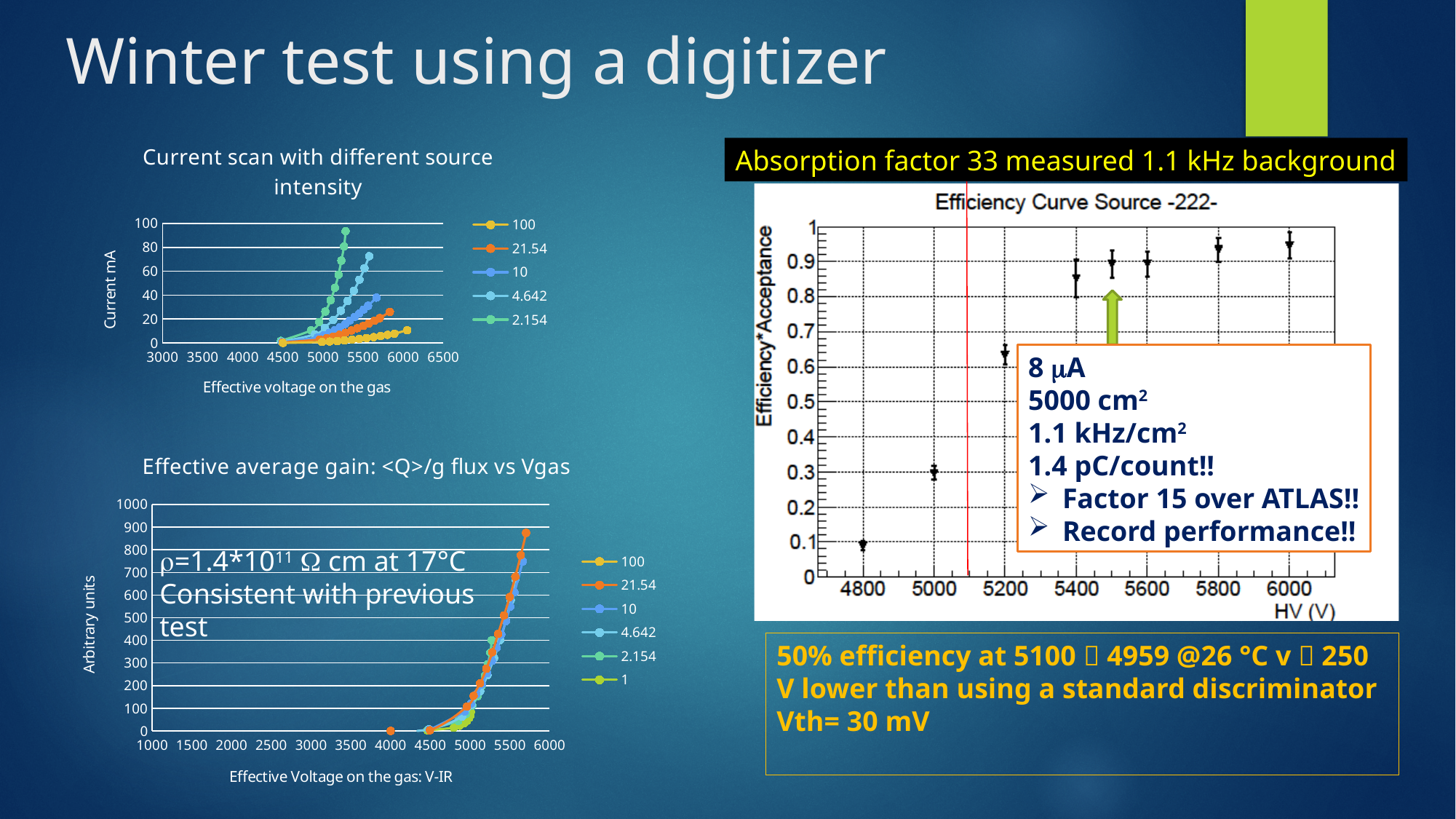
How many series does the legend of the 'Effective average gain: <Q>/g flux vs Vgas' chart list? 6 What is the title of the chart on the right side of the slide? Efficiency Curve Source -222- In the 'Current scan with different source intensity' chart, is the highest value of the 2.154 series greater or less than 80? greater In the 'Efficiency Curve Source -222-' chart, at which HV value is Efficiency*Acceptance lowest? 4800 What is the y-axis label of the 'Current scan with different source intensity' chart? Current mA In the 'Effective average gain: <Q>/g flux vs Vgas' chart, is the highest plotted value greater or less than 800? greater How many series does the legend of the 'Current scan with different source intensity' chart list? 5 In the 'Effective average gain: <Q>/g flux vs Vgas' chart, do the values rise or fall as the effective voltage increases? rise In the 'Efficiency Curve Source -222-' chart, which has the larger Efficiency*Acceptance, HV 5000 or HV 5400? 5400 In the 'Efficiency Curve Source -222-' chart, is the value at HV 5200 greater or less than 0.5? greater What kind of chart is the 'Current scan with different source intensity' chart? line chart In the 'Current scan with different source intensity' chart, which series reaches the highest current? 2.154